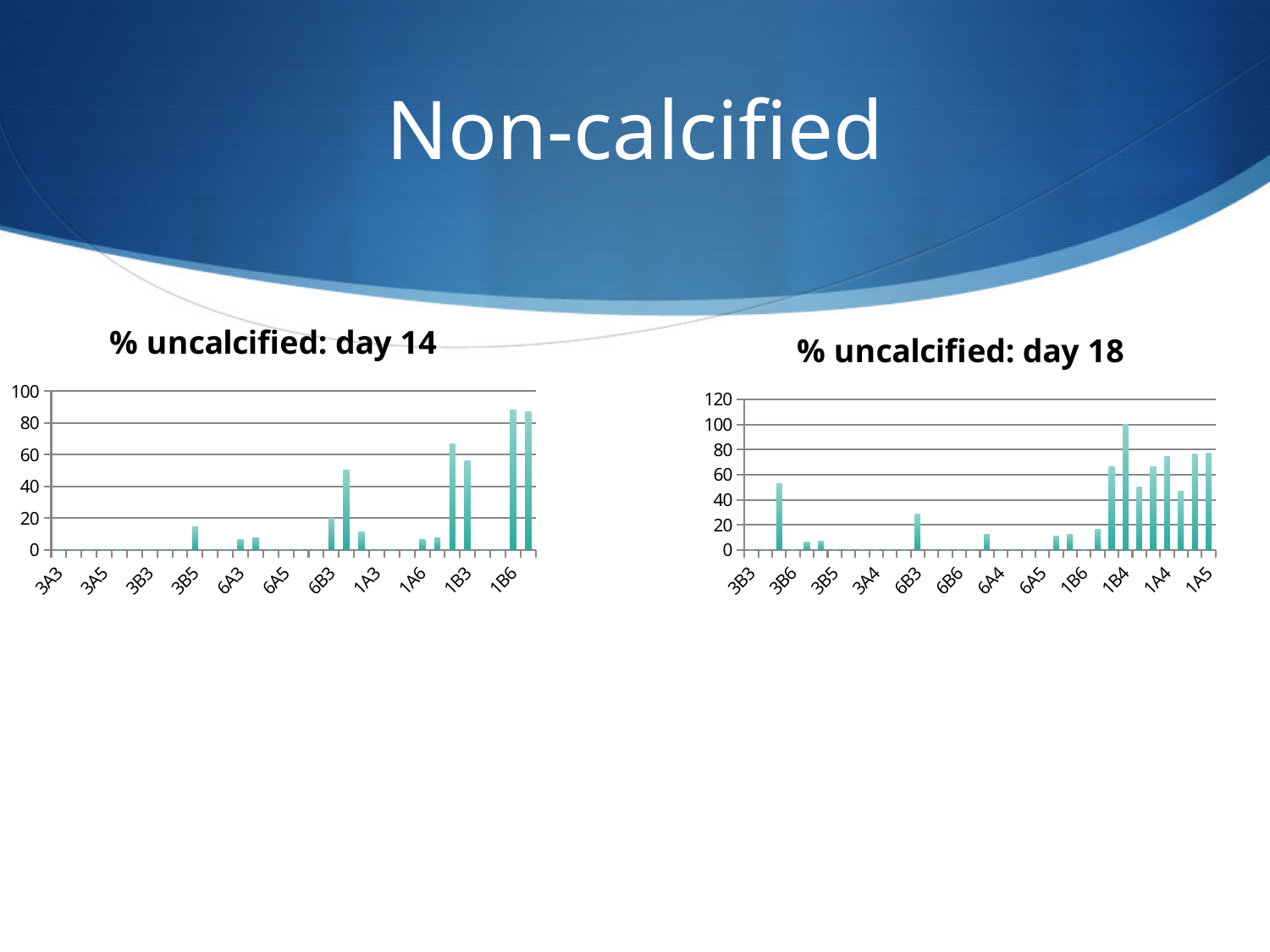
What type of chart is the '% uncalcified: day 14' chart? bar chart In the '% uncalcified: day 18' chart, is the value for 3B6 greater or less than 40? greater In the '% uncalcified: day 18' chart, is the value for 6B3 greater or less than 40? less In the '% uncalcified: day 18' chart, which is larger, the value for 3B6 or the value for 6B3? 3B6 In the '% uncalcified: day 18' chart, is the value for 1A5 greater or less than 60? greater In the '% uncalcified: day 14' chart, which is larger, the value for 1B6 or the value for 3B5? 1B6 In the '% uncalcified: day 14' chart, do the bar heights generally rise or fall from left to right along the x axis? rise What is the highest value shown on the y axis of the '% uncalcified: day 18' chart? 120 What is the title of the chart on the right side of the slide? % uncalcified: day 18